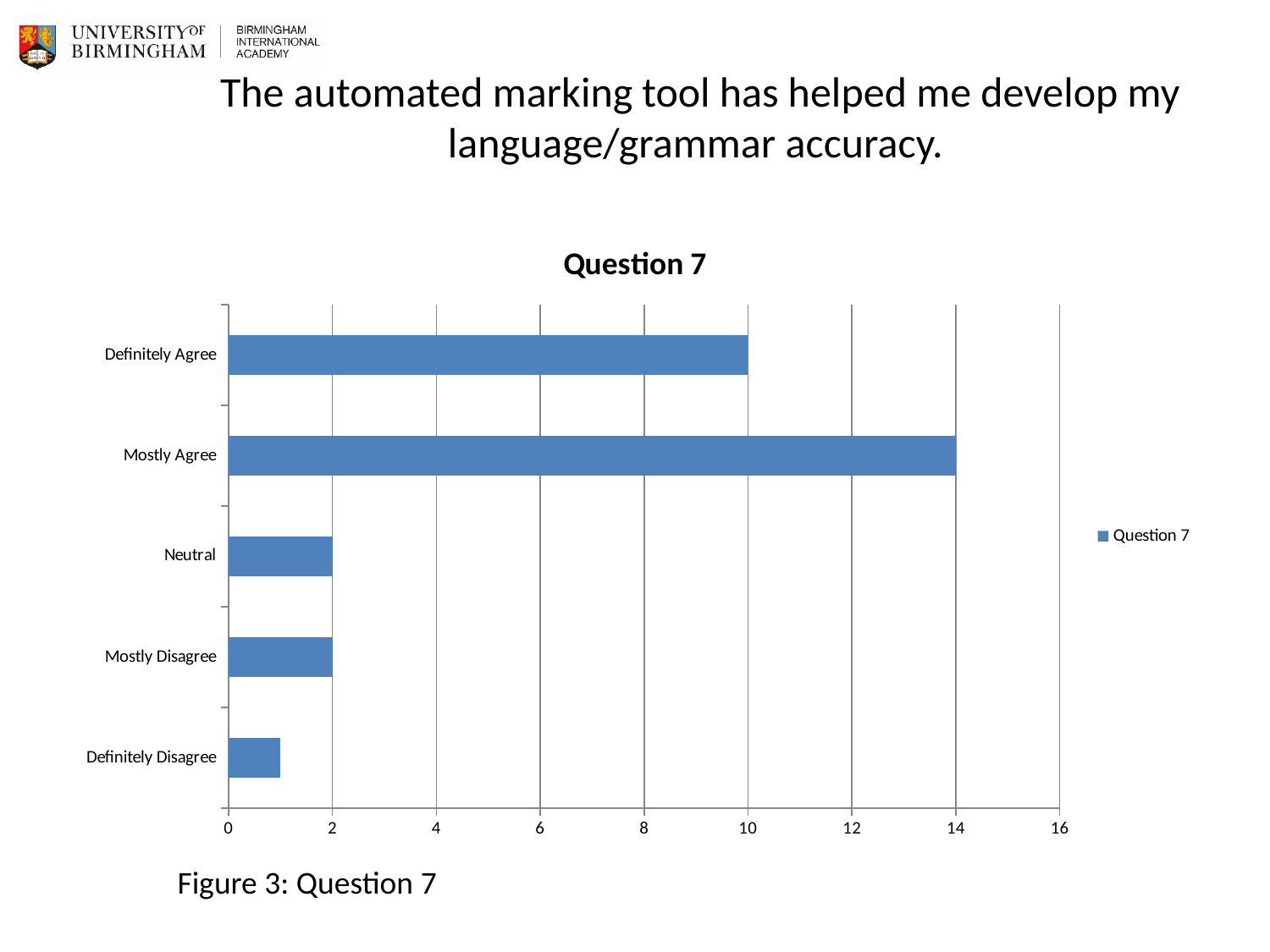
What is the value for Neutral? 2 What is the difference between the values for Mostly Agree and Definitely Agree? 4 Which category has the lowest value? Definitely Disagree Which category has the highest value? Mostly Agree What is the value for Mostly Agree? 14 What is the value for Definitely Agree? 10 How many categories are shown on the chart? 5 Which is larger, the value for Definitely Agree or the value for Neutral? Definitely Agree Is the value for Definitely Disagree greater or less than 2? less What is the title of the chart? Question 7 How many series does the legend list? 1 What kind of chart is shown on the slide? bar chart